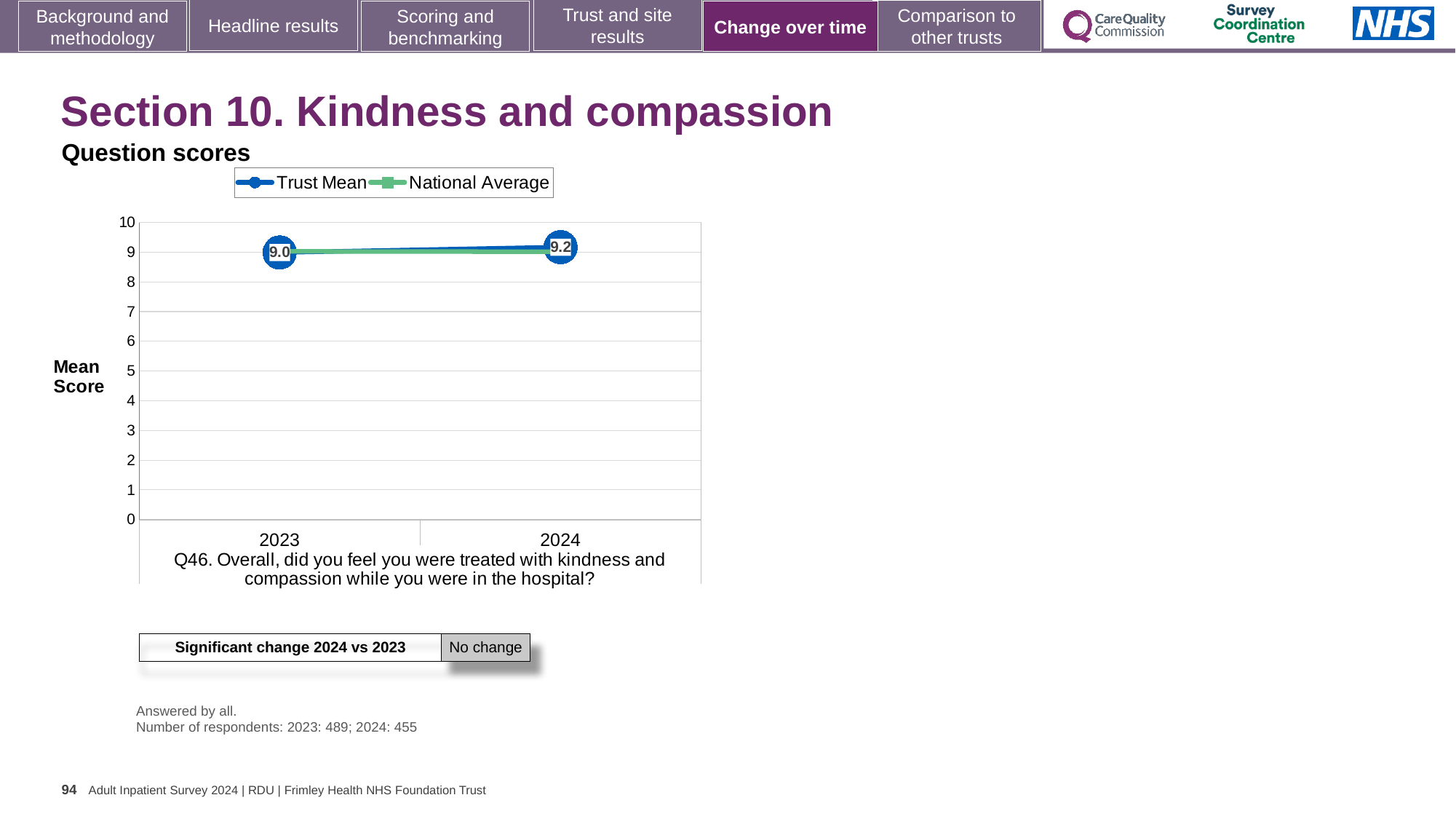
How many years are shown on the x axis of the chart? 2 What is the label on the y axis of the chart? Mean Score Is the National Average score for 2024 greater or less than 5? greater What are the two series named in the chart legend? Trust Mean and National Average What is the Trust Mean score for 2023? 9.0 Does the Trust Mean score rise or fall from 2023 to 2024? Rise What is the difference between the Trust Mean scores for 2024 and 2023? 0.2 What kind of chart is shown on the slide? Line chart Is the Trust Mean score for 2023 greater or less than 8? greater Which year has the higher Trust Mean score, 2023 or 2024? 2024 What is the Trust Mean score for 2024? 9.2 How many series does the chart legend list? 2